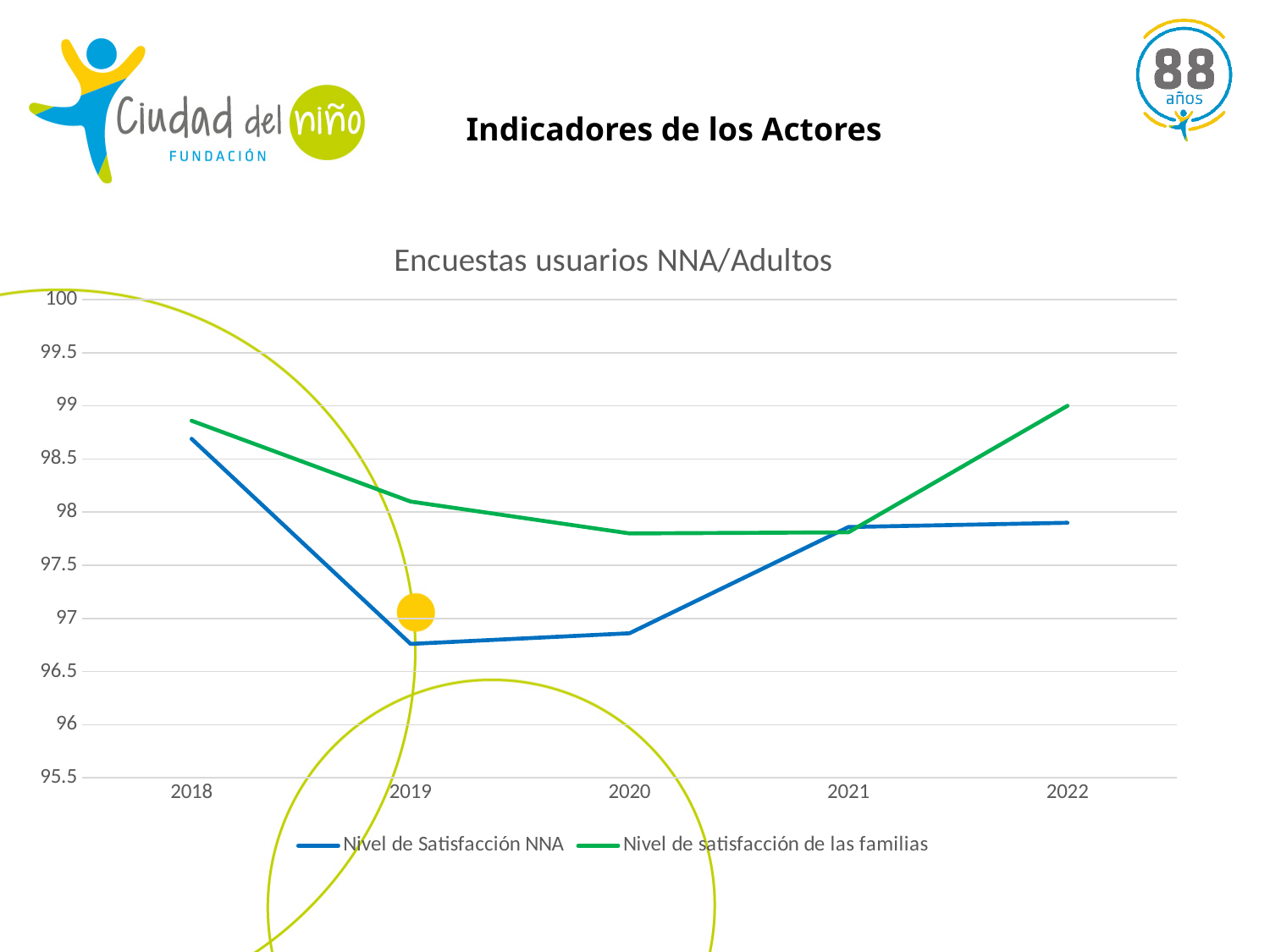
In which year is the Nivel de Satisfacción NNA series at its lowest? 2019 Does the Nivel de Satisfacción NNA series rise or fall from 2019 to 2022? rise How many years are plotted along the x axis? 5 How many series does the legend list? 2 What is the title of the chart? Encuestas usuarios NNA/Adultos Is the value for Nivel de Satisfacción NNA in 2019 greater or less than 97? less What kind of chart is shown on the slide? line chart In which year is the Nivel de satisfacción de las familias series at its highest? 2022 In 2019, which series has the higher value, Nivel de Satisfacción NNA or Nivel de satisfacción de las familias? Nivel de satisfacción de las familias Which series is drawn in green? Nivel de satisfacción de las familias Does the Nivel de satisfacción de las familias series rise or fall from 2018 to 2020? fall Is the value for Nivel de satisfacción de las familias in 2018 greater or less than 98.5? greater